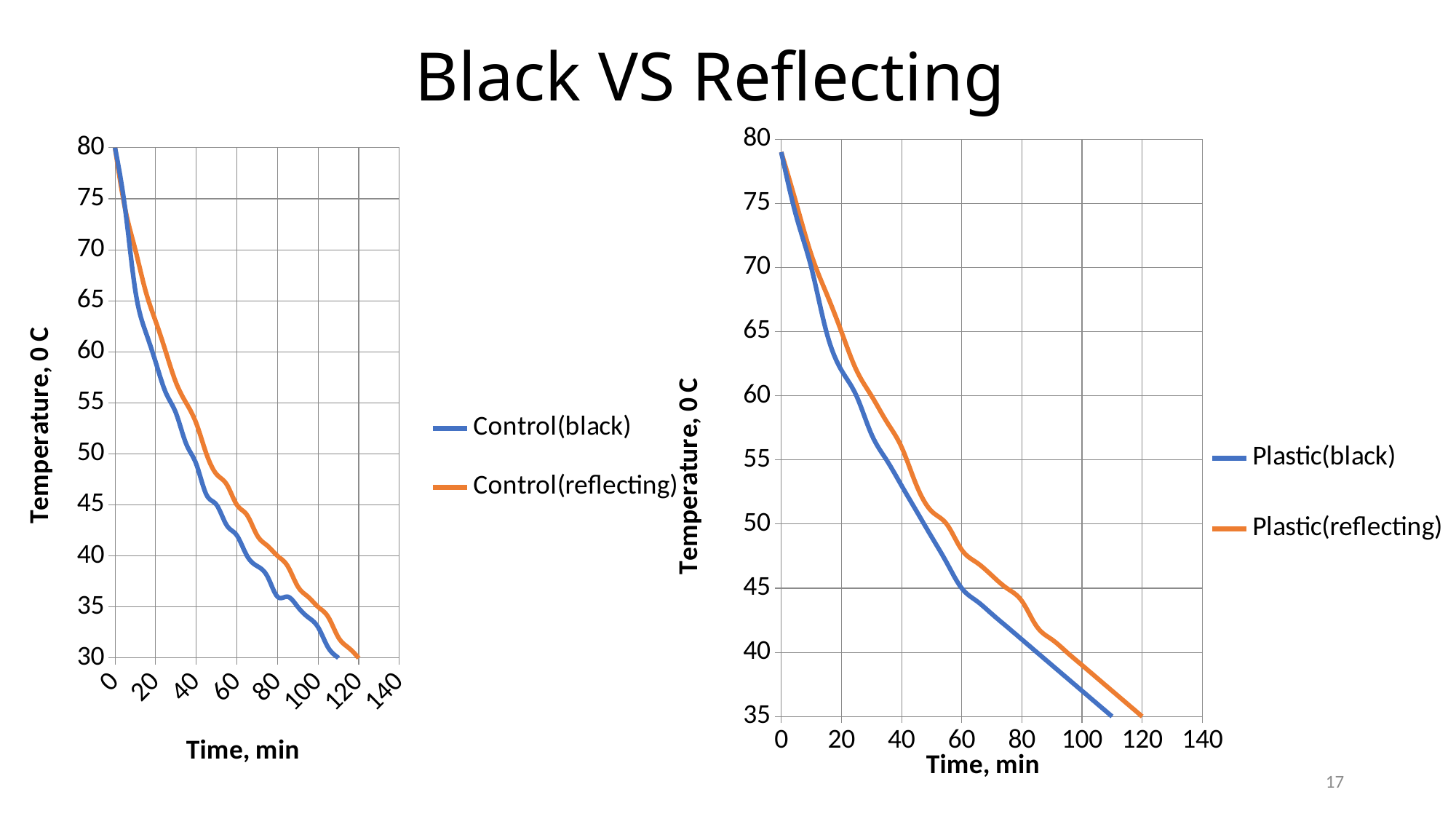
What is the x-axis title of the right-hand chart? Time, min In the left-hand chart, is the value for Control(black) at 60 min greater or less than 45? less In the left-hand chart, what is the temperature of Control(black) at time 0? 80 In the left-hand chart, which series has the higher temperature at 60 min, Control(black) or Control(reflecting)? Control(reflecting) In the right-hand chart, is the value for Plastic(black) at 100 min greater or less than 40? less In the right-hand chart, does the Plastic(black) line rise or fall along the x axis? fall In the left-hand chart, is the value for Control(reflecting) at 40 min greater or less than 50? greater In the left-hand chart, do the temperature values rise or fall as time increases? fall In the right-hand chart, which series has the higher temperature at 40 min, Plastic(black) or Plastic(reflecting)? Plastic(reflecting) What kind of chart is the chart on the left of the slide? line chart How many series does the legend of the right-hand chart list? 2